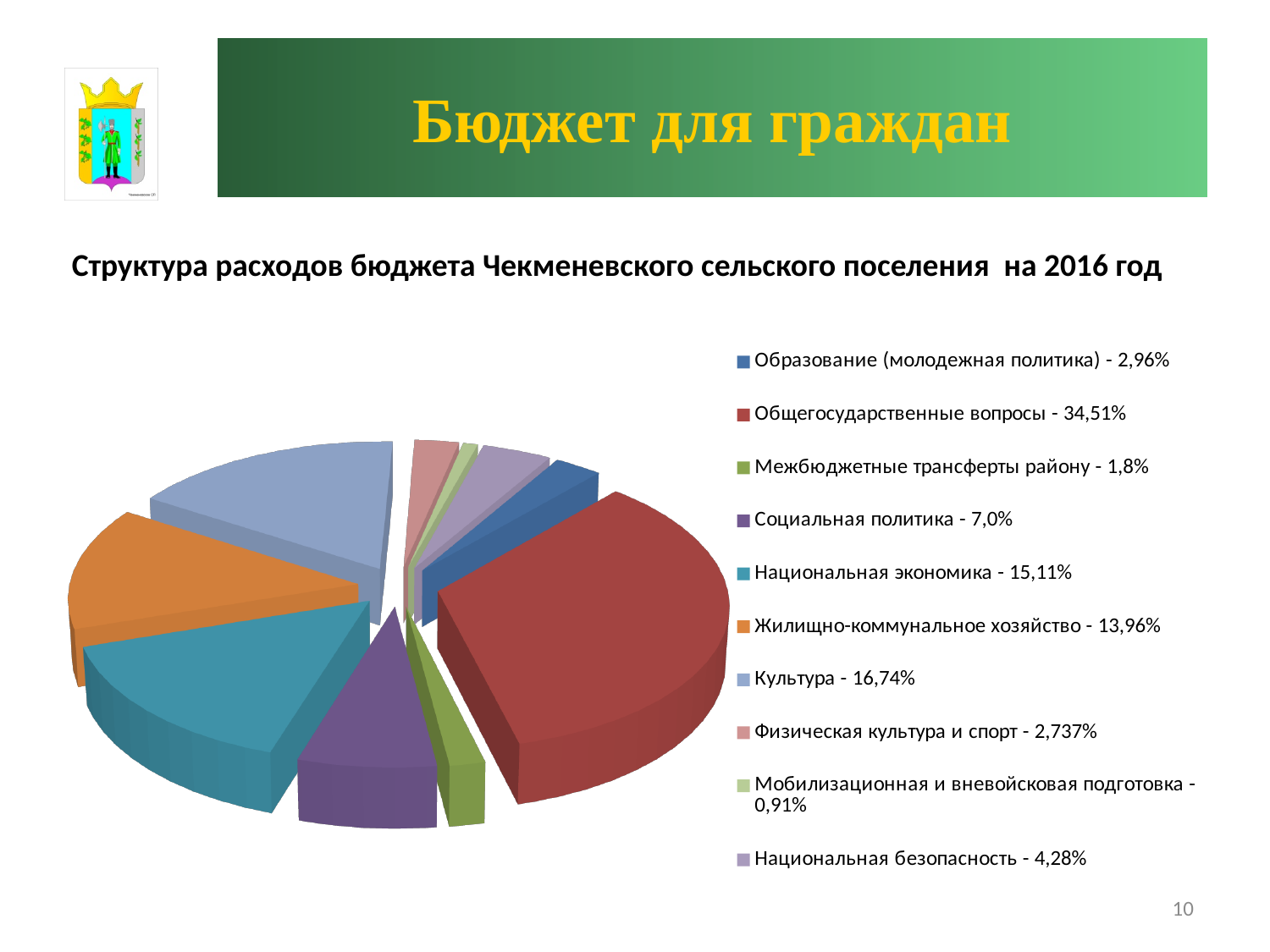
What is the difference in percentage points between Культура and Национальная экономика? 1,63% What share of the budget expenditure is Культура? 16,74% How many categories does the pie chart's legend list? 10 What share of the budget expenditure is Мобилизационная и вневойсковая подготовка? 0,91% Which category has the smallest share of the budget expenditure? Мобилизационная и вневойсковая подготовка What is the difference in percentage points between Общегосударственные вопросы and Культура? 17,77% What share of the budget expenditure is Общегосударственные вопросы? 34,51% What kind of chart is shown on the slide? pie chart What share of the budget expenditure is Национальная экономика? 15,11% Which category has the largest share of the budget expenditure? Общегосударственные вопросы Which is larger: the share for Культура or the share for Жилищно-коммунальное хозяйство? Культура What is the title of the chart on the slide? Структура расходов бюджета Чекменевского сельского поселения на 2016 год